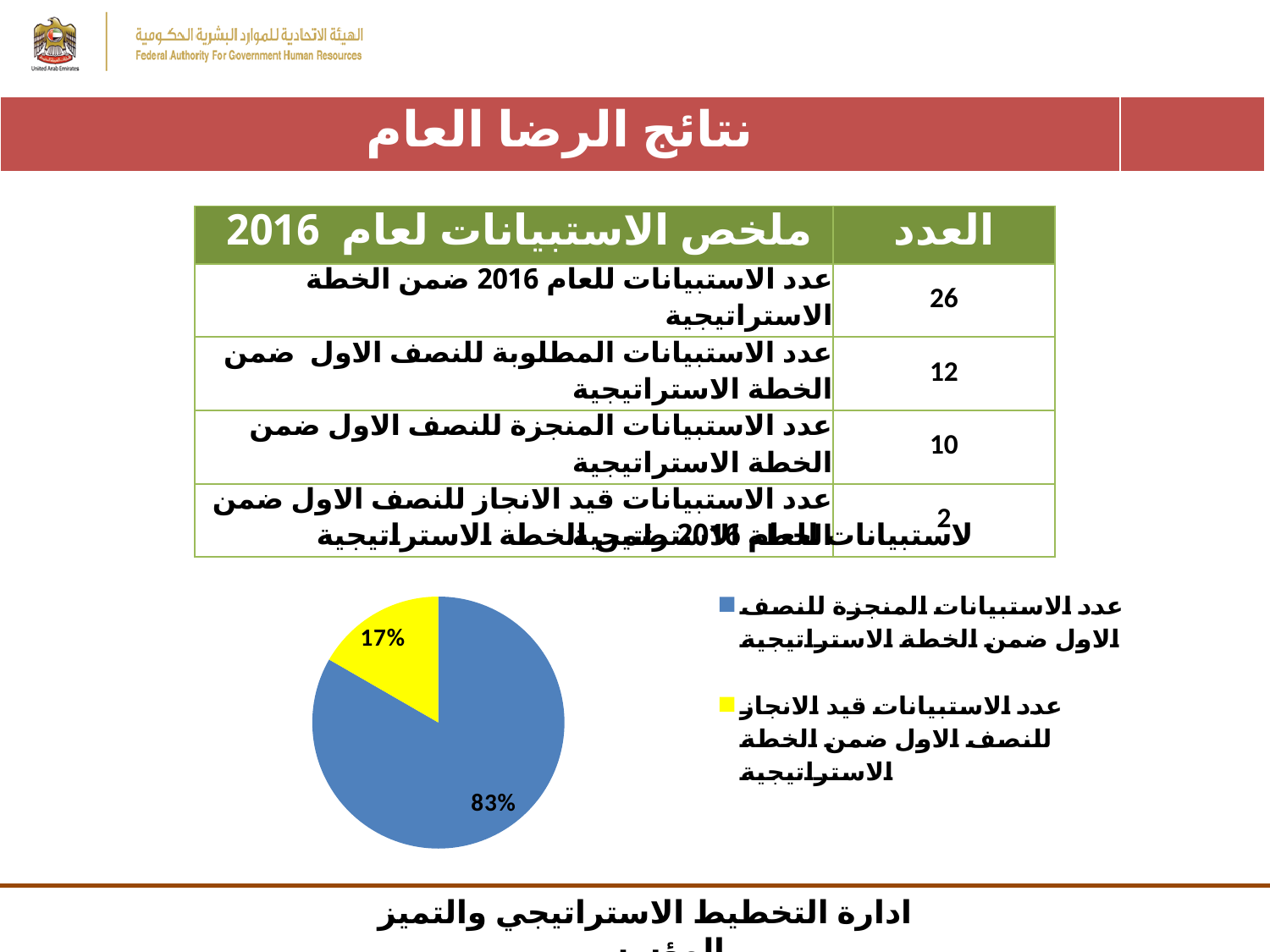
What colour is the slice labelled 17% in the pie chart? yellow How many entries does the pie chart's legend list? 2 What kind of chart is shown on the slide? pie chart Which slice is larger: the one for completed surveys (المنجزة) or the one for surveys in progress (قيد الانجاز)? المنجزة (83%) Which legend category has the largest slice of the pie chart? عدد الاستبيانات المنجزة للنصف الاول ضمن الخطة الاستراتيجية Which legend category has the smallest slice of the pie chart? عدد الاستبيانات قيد الانجاز للنصف الاول ضمن الخطة الاستراتيجية What is the difference in percentage points between the two slices of the pie chart? 66 What share of the pie does the slice for عدد الاستبيانات المنجزة للنصف الاول ضمن الخطة الاستراتيجية represent? 83% What colour is the slice labelled 83% in the pie chart? blue Is the share for عدد الاستبيانات قيد الانجاز للنصف الاول ضمن الخطة الاستراتيجية greater or less than 50%? less How many slices does the pie chart have? 2 What share of the pie does the slice for عدد الاستبيانات قيد الانجاز للنصف الاول ضمن الخطة الاستراتيجية represent? 17%